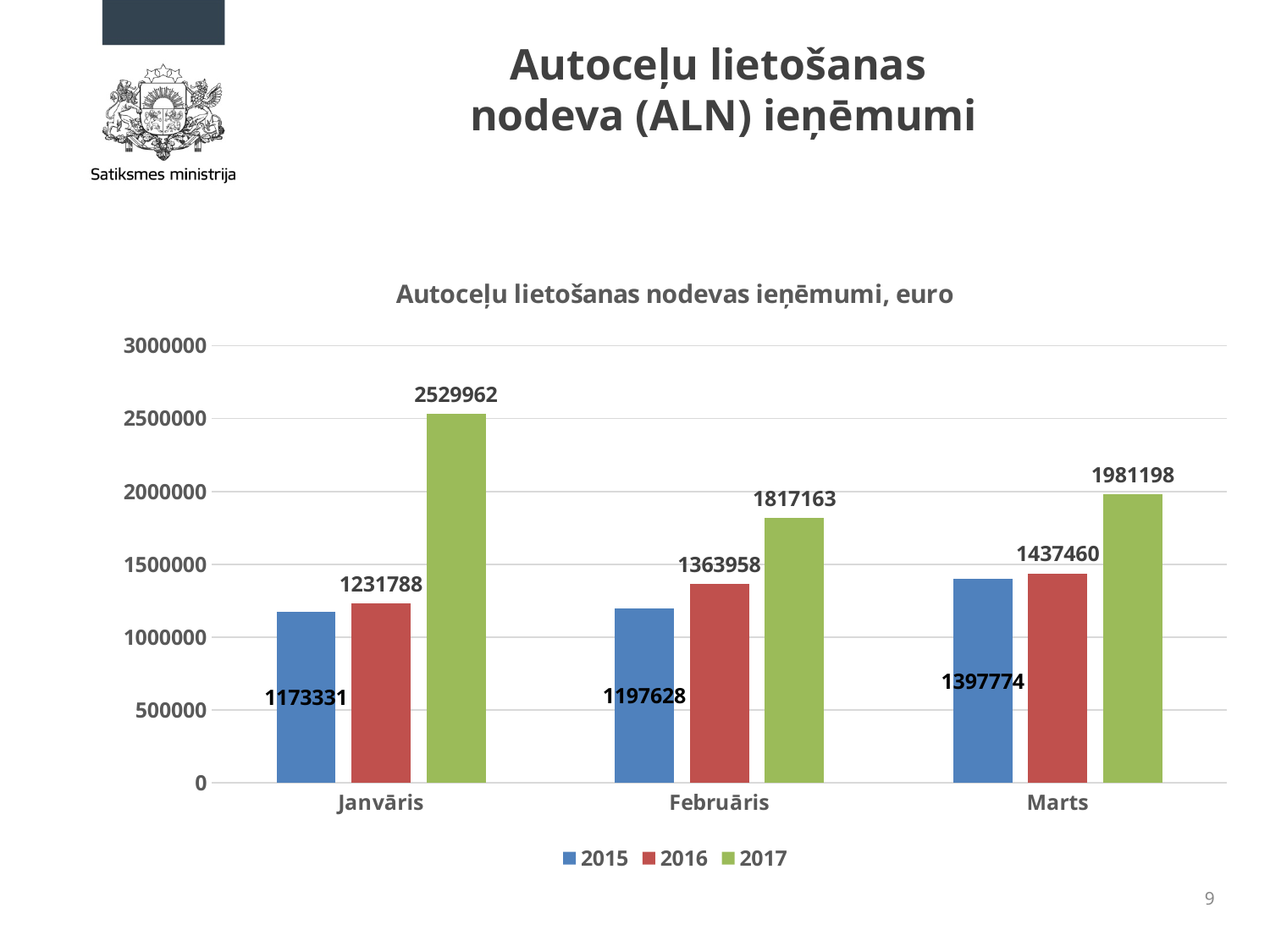
How many months are shown on the x axis? 3 What is the difference between the 2017 and 2015 values in Februāris? 619535 Which month has the highest value for the 2017 series? Janvāris What is the value for 2016 in Marts? 1437460 What is the value for 2015 in Februāris? 1197628 Which month has the lowest value for the 2015 series? Janvāris Is the value for 2016 in Februāris greater or less than 1500000? less What is the value for 2017 in Janvāris? 2529962 What is the difference between the 2017 and 2016 values in Janvāris? 1298174 How many series does the legend list? 3 What kind of chart is shown on the slide? bar chart Which is larger: the 2017 value in Februāris or the 2017 value in Marts? Marts